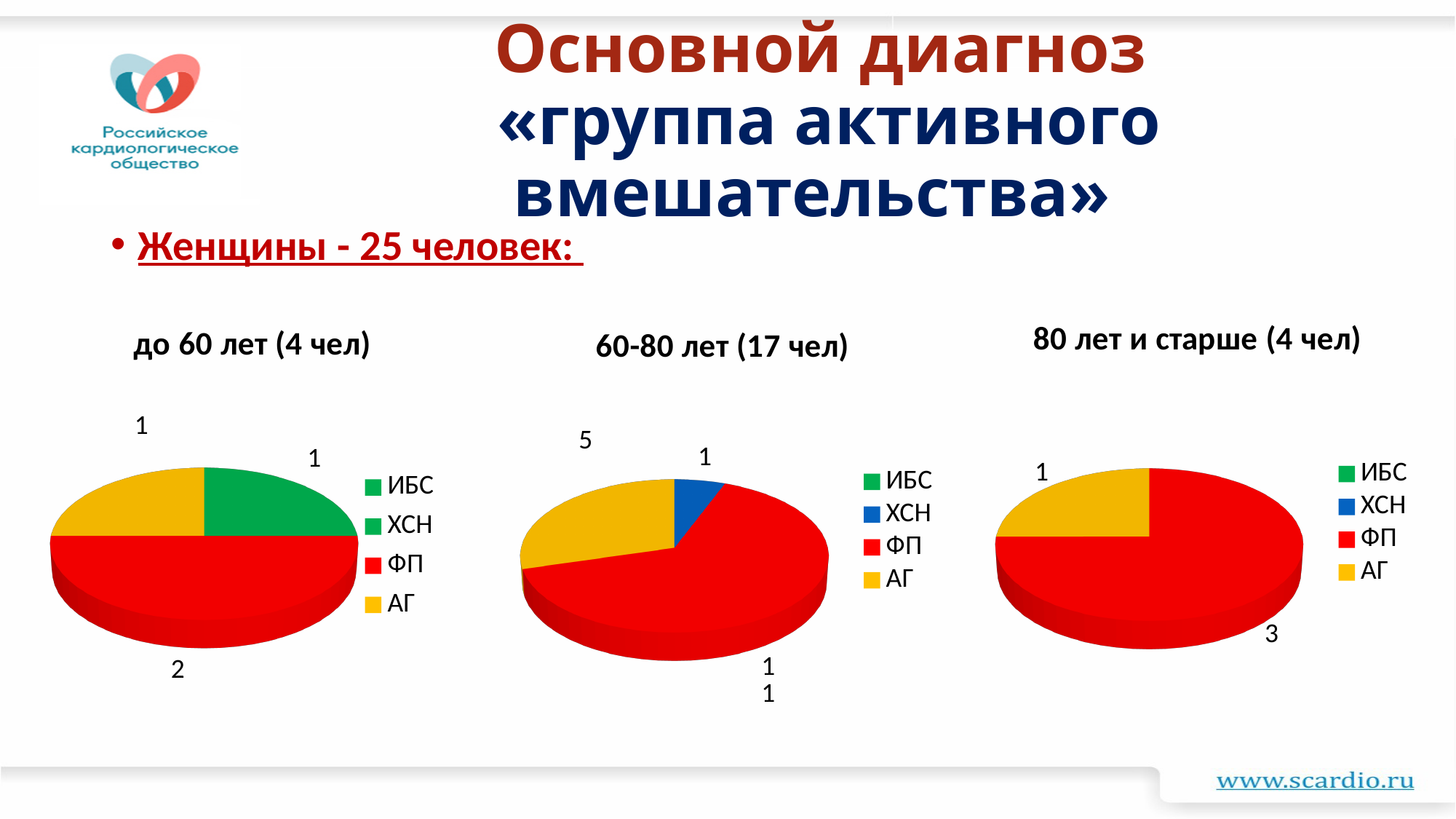
In the pie chart titled "60-80 лет (17 чел)", which is larger, the value for ФП or the value for АГ? ФП In the pie chart titled "80 лет и старше (4 чел)", what is the value for ФП? 3 In the pie chart titled "80 лет и старше (4 чел)", what is the value for АГ? 1 What kind of chart is used on this slide? Pie chart In the pie chart titled "60-80 лет (17 чел)", what is the value for ФП? 11 In the pie chart titled "60-80 лет (17 чел)", what is the value for ХСН? 1 In the pie chart titled "60-80 лет (17 чел)", which category has the largest slice? ФП In the pie chart titled "80 лет и старше (4 чел)", what share of the pie does ФП represent? 75% In the pie chart titled "60-80 лет (17 чел)", what is the value for АГ? 5 In the pie chart titled "до 60 лет (4 чел)", what is the value for ФП? 2 In the pie chart titled "80 лет и старше (4 чел)", what is the difference between the values for ФП and АГ? 2 How many entries does the legend of the pie chart titled "60-80 лет (17 чел)" list? 4